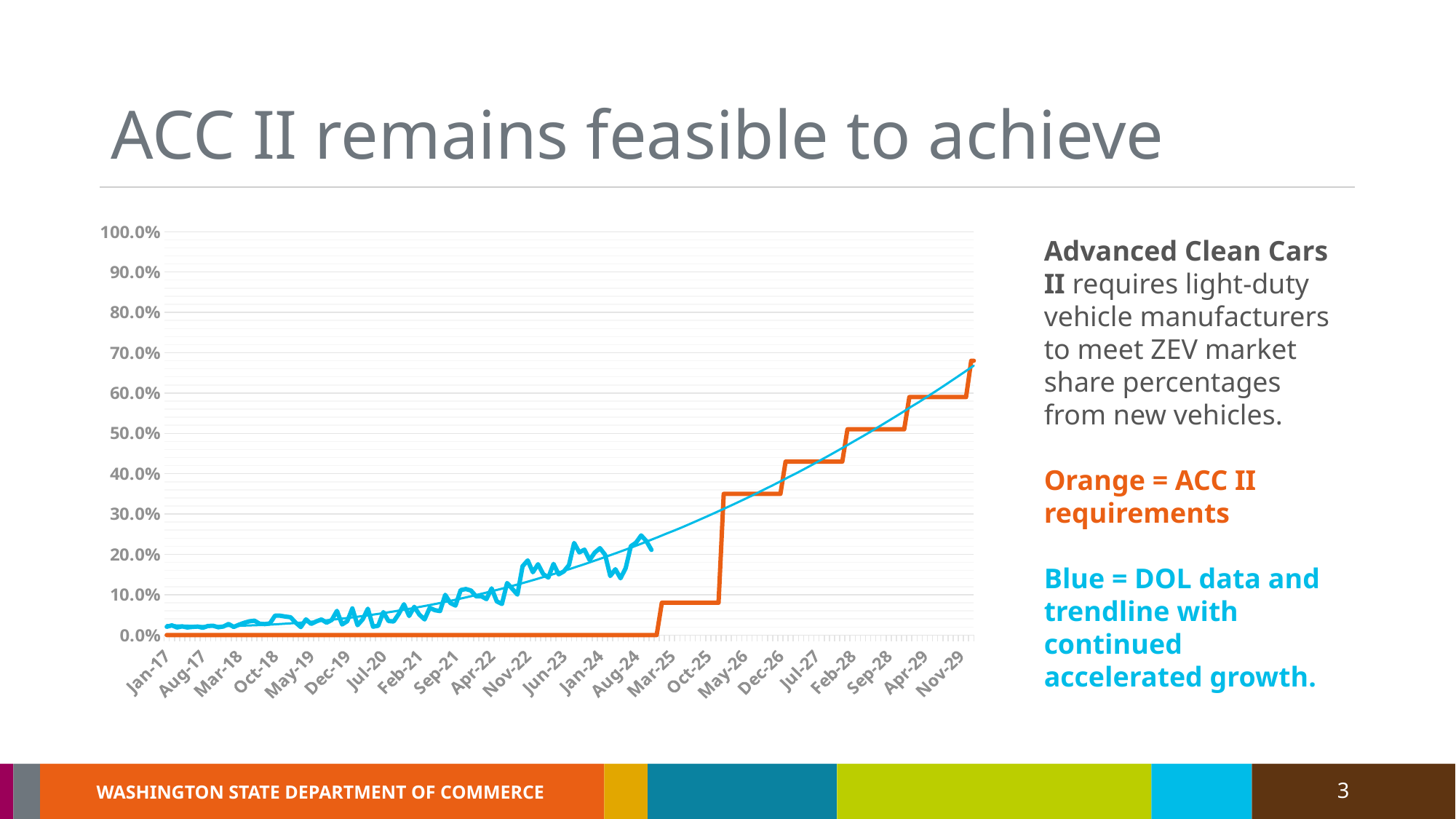
What does the orange line on the chart represent? ACC II requirements Does the blue DOL data line generally rise or fall from Jan-17 to Aug-24? rise Is the orange ACC II requirement value at Oct-25 greater or less than 10.0%? less Is the orange ACC II requirement value at May-26 greater or less than 30.0%? greater What does the blue line on the chart represent? DOL data and trendline with continued accelerated growth What is the highest value shown on the vertical axis? 100.0% At Jan-24, which line is higher, the blue DOL data line or the orange ACC II requirements line? blue DOL data line Do the ACC II requirements (orange line) rise or fall from Mar-25 to Nov-29? rise Is the orange ACC II requirement value at Jan-24 greater or less than 10.0%? less What kind of chart is shown on the slide? line chart